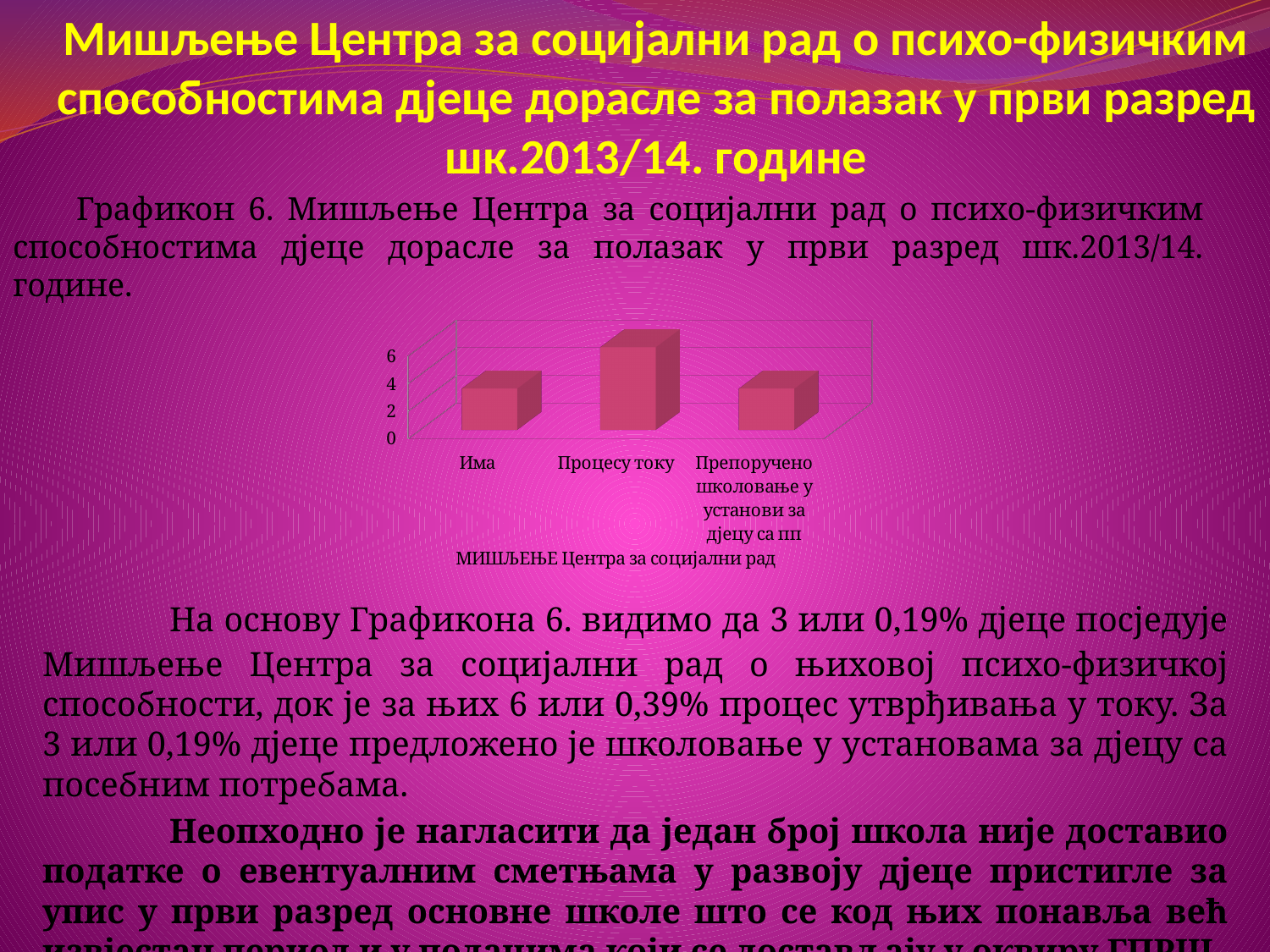
Which category has the highest bar in the chart? Процесу току What is the highest tick value shown on the vertical axis of the chart? 6 Which bar is taller, "Има" or "Процесу току"? Процесу току Which bar is taller, "Процесу току" or "Препоручено школовање у установи за дјецу са пп"? Процесу току Is the value for "Има" greater or less than 2? greater How many categories are shown on the x axis of the chart? 3 What is the axis title shown below the categories of the chart? МИШЉЕЊЕ Центра за социјални рад Is the value for "Процесу току" greater or less than 4? greater Is the value for "Препоручено школовање у установи за дјецу са пп" greater or less than 4? less What kind of chart is shown on the slide? bar chart